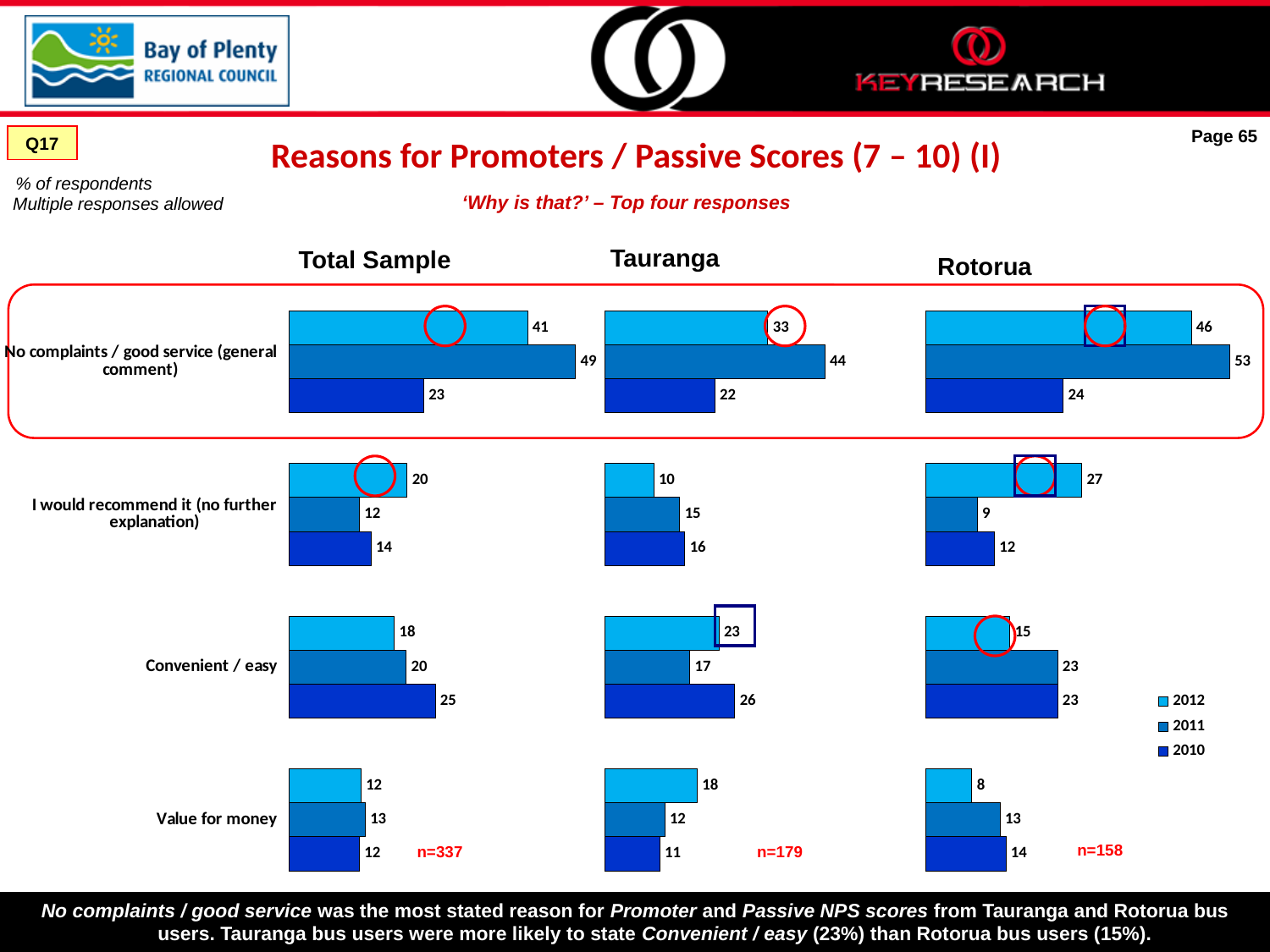
In the Rotorua chart, which category has the highest 2011 value? No complaints / good service (general comment) In the Rotorua chart, what is the 2010 value for 'Value for money'? 14 In the Total Sample chart, what is the difference between the 2011 and 2012 values for 'No complaints / good service (general comment)'? 8 What type of chart is used for the Total Sample data? Bar chart In the Tauranga chart, what is the 2012 value for 'Convenient / easy'? 23 How many series does the legend list? 3 In the Total Sample chart, what is the 2011 value for 'No complaints / good service (general comment)'? 49 How many categories are shown in the Tauranga chart? 4 What is the sample size (n) shown for the Tauranga chart? n=179 In the Tauranga chart, which category has the lowest 2010 value? Value for money For 'Convenient / easy' in 2012, which is larger: the Tauranga value or the Rotorua value? Tauranga In the Rotorua chart, what is the 2012 value for 'I would recommend it (no further explanation)'? 27